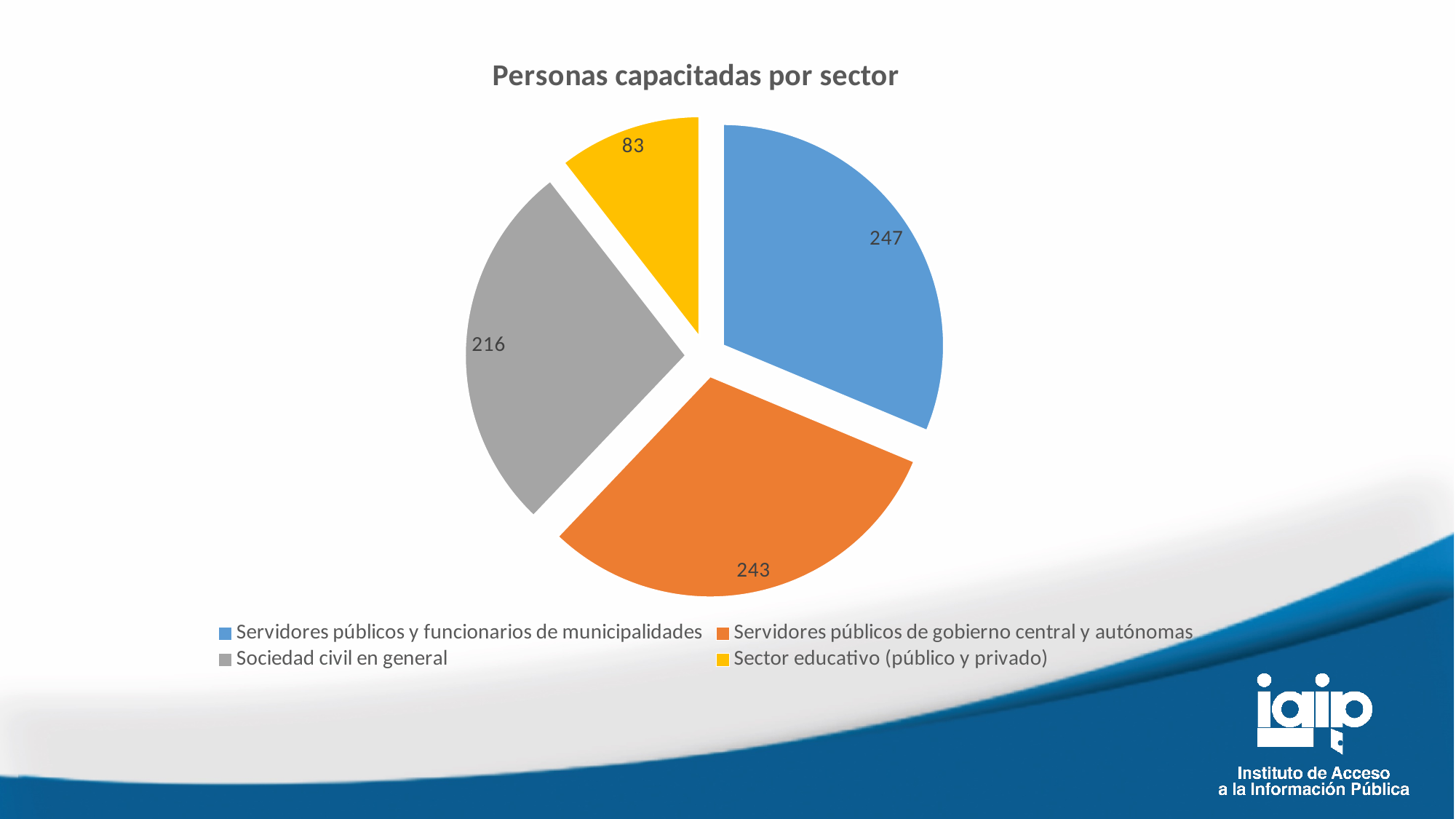
What is the difference between the values for Servidores públicos de gobierno central y autónomas and Sociedad civil en general? 27 How many slices does the pie chart have? 4 Which is larger: the value for Sociedad civil en general or the value for Sector educativo (público y privado)? Sociedad civil en general Which sector has the largest slice? Servidores públicos y funcionarios de municipalidades What is the title of the chart? Personas capacitadas por sector What type of chart is shown on the slide? pie chart How many entries does the legend list? 4 What is the value for Sociedad civil en general? 216 What is the total of all slices in the pie chart? 789 Which sector has the smallest slice? Sector educativo (público y privado) What is the value for Sector educativo (público y privado)? 83 What is the value for Servidores públicos y funcionarios de municipalidades? 247